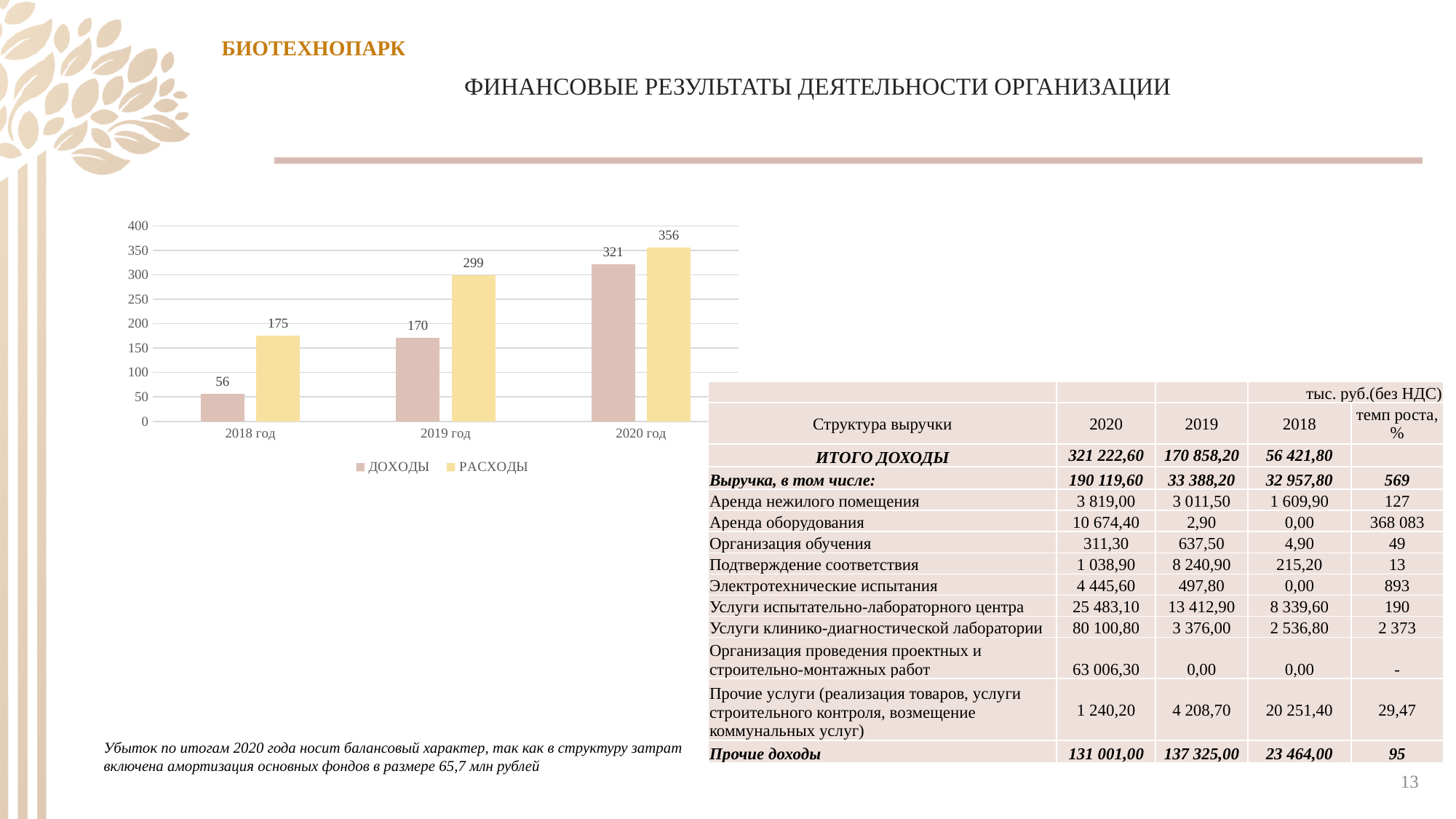
Is the value of РАСХОДЫ for 2018 год greater or less than 150? greater How many years are shown on the x axis of the chart? 3 What is the difference between РАСХОДЫ and ДОХОДЫ in 2019 год? 129 Which is larger in 2020 год, ДОХОДЫ or РАСХОДЫ? РАСХОДЫ Which year has the lowest ДОХОДЫ value? 2018 год What is the value of РАСХОДЫ for 2020 год? 356 Which year has the highest РАСХОДЫ value? 2020 год Do the ДОХОДЫ values rise or fall from 2018 год to 2020 год? rise How many series does the chart legend list? 2 What kind of chart is shown on the slide? bar chart What is the value of ДОХОДЫ for 2019 год? 170 What is the value of ДОХОДЫ for 2018 год? 56